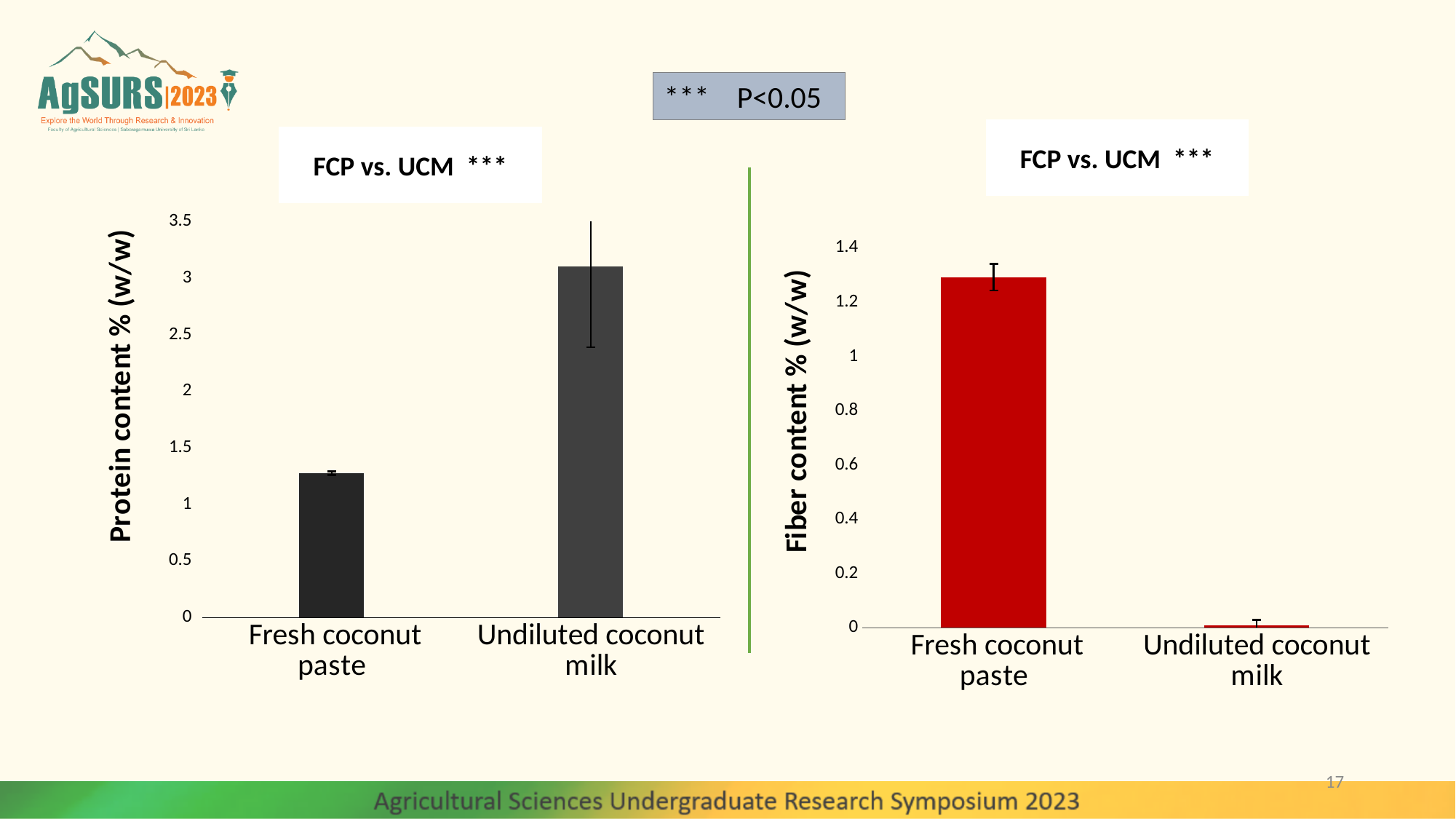
In the right chart (Fiber content), how many categories are shown on the x axis? 2 What kind of chart is the left chart (Protein content)? bar chart In the right chart (Fiber content), which category has the lowest value? Undiluted coconut milk In the left chart (Protein content), is the value for Fresh coconut paste greater or less than 1.5? less In the left chart (Protein content), is the value for Undiluted coconut milk greater or less than 3? greater What colour are the bars in the right chart (Fiber content)? red In the left chart (Protein content), which category has the highest value? Undiluted coconut milk In the left chart (Protein content), how many categories are shown on the x axis? 2 What is the y-axis title of the right chart? Fiber content % (w/w) In the right chart (Fiber content), is the value for Fresh coconut paste greater or less than 1.2? greater What kind of chart is the right chart (Fiber content)? bar chart In the right chart (Fiber content), which is larger: Fresh coconut paste or Undiluted coconut milk? Fresh coconut paste